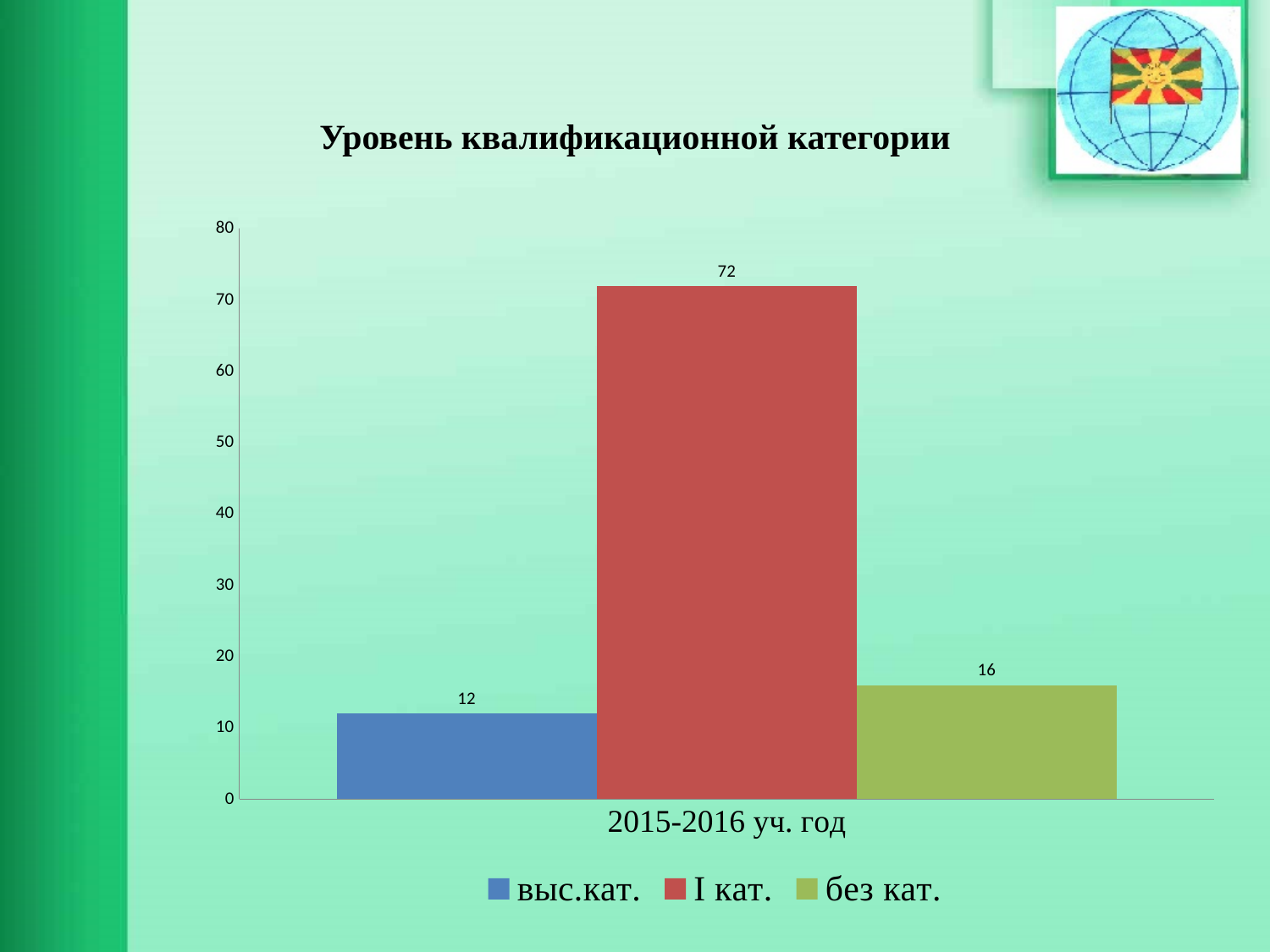
What is the value for без кат. in 2015-2016 уч. год? 16 What kind of chart is shown on the slide? bar chart What is the difference between the values for I кат. and без кат.? 56 What is the value for выс.кат. in 2015-2016 уч. год? 12 Which series has the highest value? I кат. What is the value for I кат. in 2015-2016 уч. год? 72 How many series does the legend list? 3 Is the value for I кат. greater or less than 70? greater Which series has the lowest value? выс.кат. What is the title of the chart? Уровень квалификационной категории What is the difference between the values for без кат. and выс.кат.? 4 Which is larger, the value for без кат. or the value for выс.кат.? без кат.